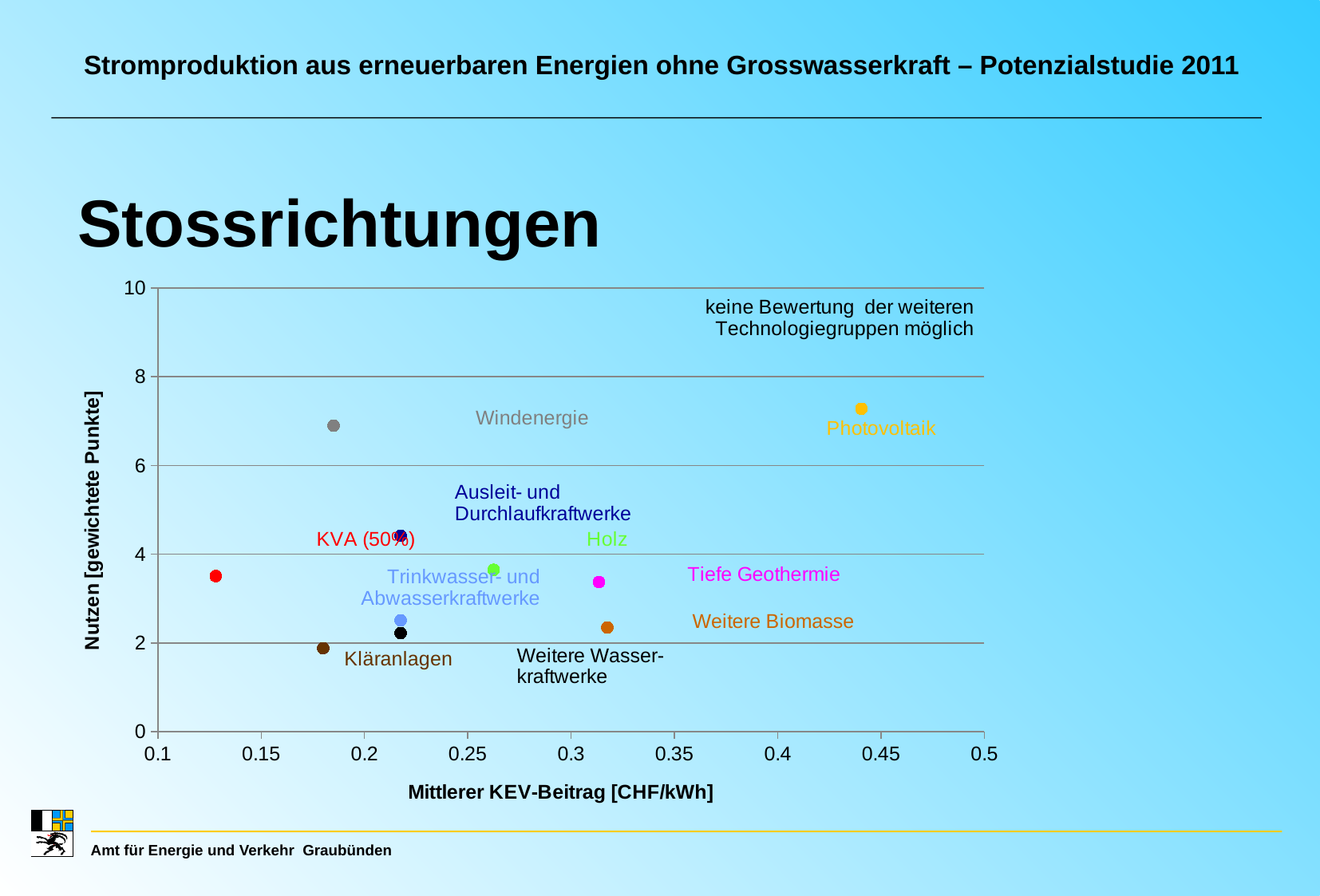
Which technology group has the lowest Nutzen (gewichtete Punkte)? Kläranlagen How many labelled technology groups are plotted as points in the chart? 10 Is the Nutzen value for Kläranlagen greater or less than 2? less Which technology group has the lowest Mittlerer KEV-Beitrag? KVA (50%) Is the Mittlerer KEV-Beitrag for Photovoltaik greater or less than 0.4? greater What is the title of the x axis of the chart? Mittlerer KEV-Beitrag [CHF/kWh] Which has the higher Nutzen value, Windenergie or Holz? Windenergie Which technology group has the highest Mittlerer KEV-Beitrag? Photovoltaik Is the Nutzen value for Windenergie greater or less than 6? greater What kind of chart is shown on the slide? Scatter chart Which technology group has the highest Nutzen (gewichtete Punkte)? Photovoltaik